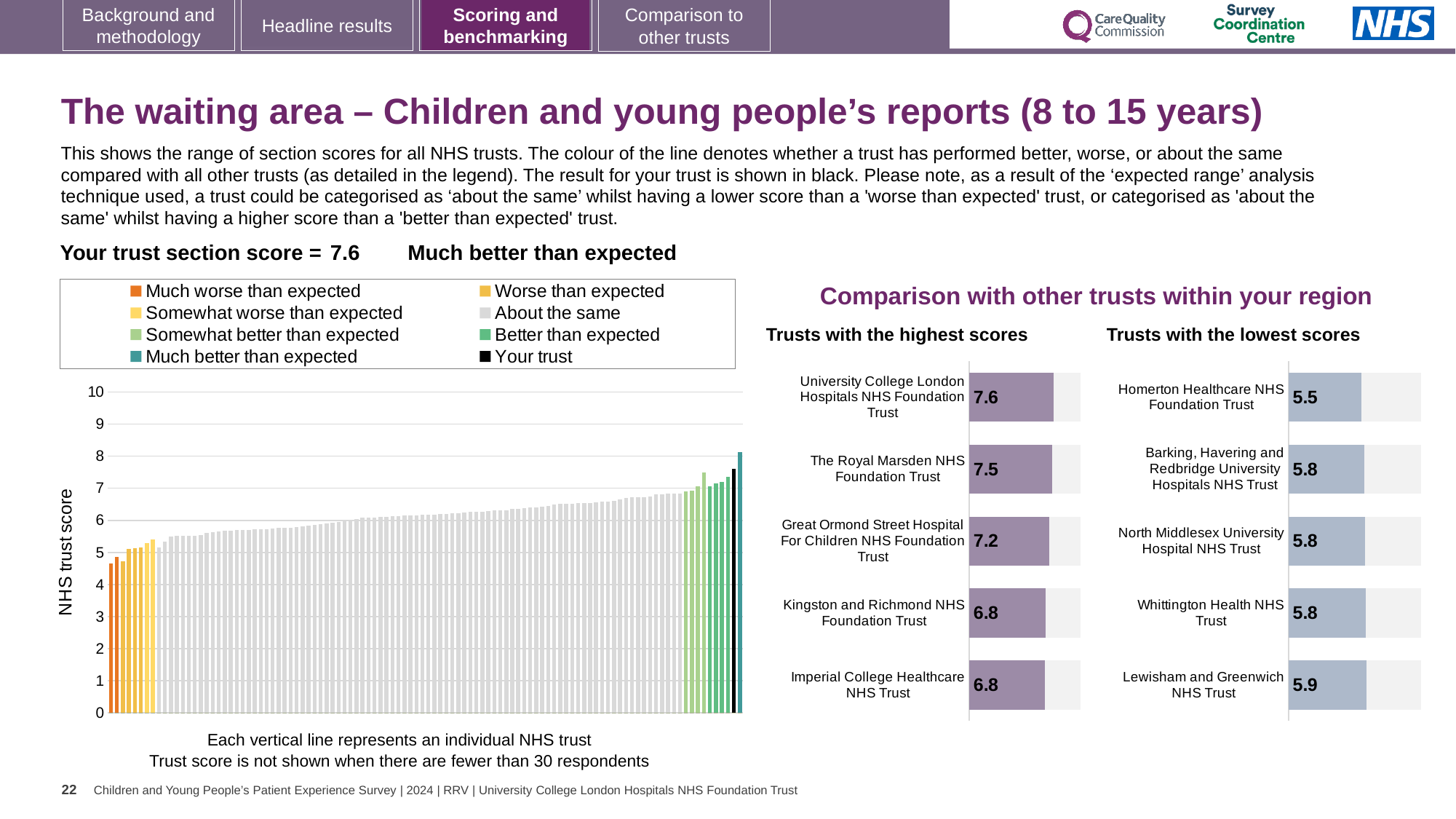
Which has the higher score: Kingston and Richmond NHS Foundation Trust in the highest scores chart, or Lewisham and Greenwich NHS Trust in the lowest scores chart? Kingston and Richmond NHS Foundation Trust In the 'Trusts with the lowest scores' chart, what is the score for Lewisham and Greenwich NHS Trust? 5.9 How many entries does the legend of the 'NHS trust score' chart on the left list? 8 What kind of chart is the 'NHS trust score' chart on the left of the slide? Bar chart In the 'Trusts with the lowest scores' chart, which trust has the lowest score? Homerton Healthcare NHS Foundation Trust In the 'Trusts with the highest scores' chart, what is the score for Great Ormond Street Hospital For Children NHS Foundation Trust? 7.2 In the 'NHS trust score' chart on the left, is the value of the black 'Your trust' bar greater or less than 7? greater In the 'Trusts with the lowest scores' chart, what is the score for Homerton Healthcare NHS Foundation Trust? 5.5 In the 'Trusts with the highest scores' chart, which trust has the highest score? University College London Hospitals NHS Foundation Trust In the 'NHS trust score' chart on the left, do the bars rise or fall from left to right? Rise How many trusts are shown in the 'Trusts with the lowest scores' chart? 5 In the 'Trusts with the highest scores' chart, what is the difference between the scores of University College London Hospitals NHS Foundation Trust and The Royal Marsden NHS Foundation Trust? 0.1